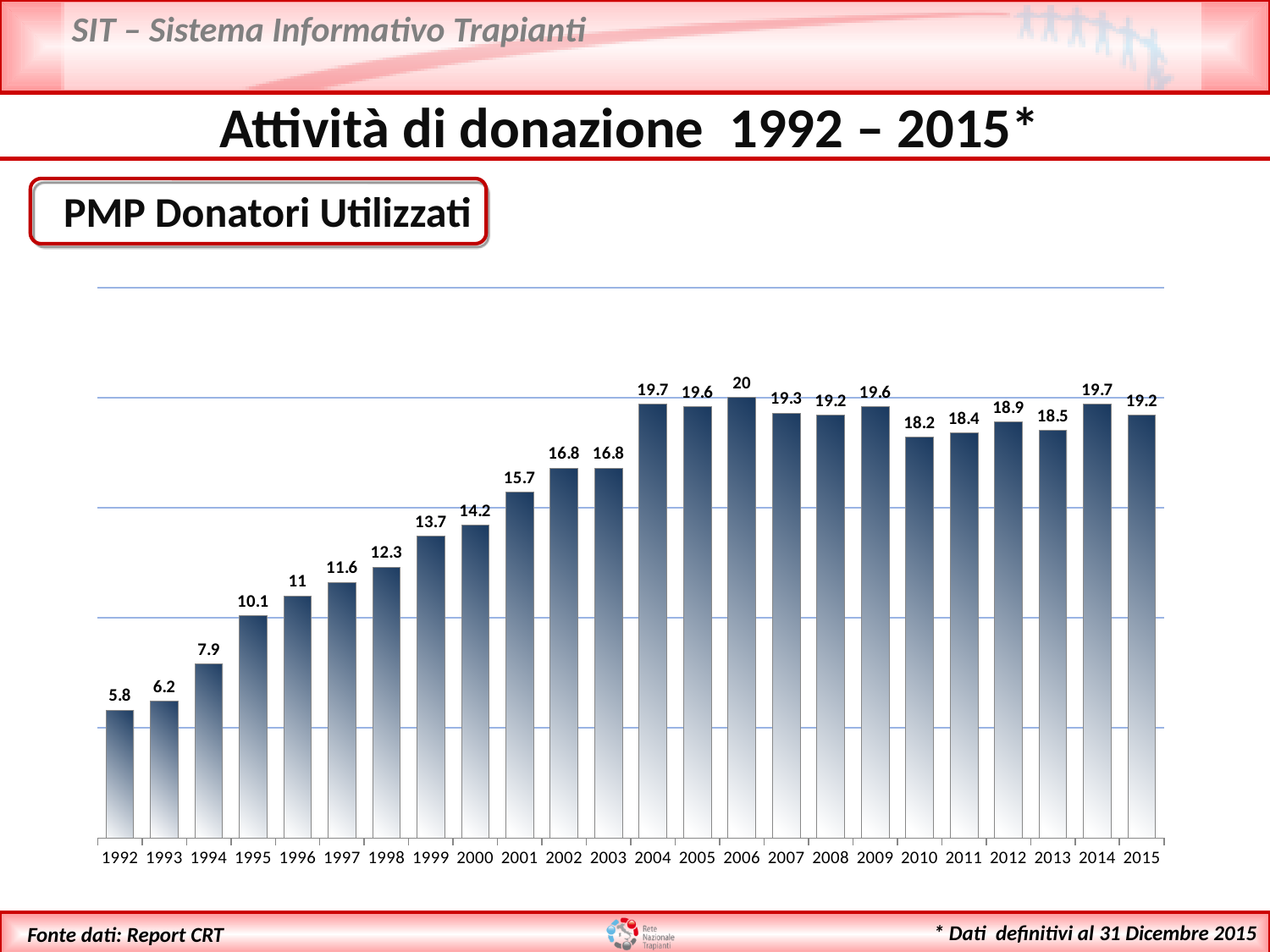
How many years (bars) are shown in the chart? 24 What is the difference between the values for 2006 and 1992? 14.2 What is the value shown for 2015? 19.2 What kind of chart is shown on the slide? Bar chart Do the values rise or fall from 1992 to 2004? Rise Which year has the highest value in the chart? 2006 What is the title shown in the box above the chart? PMP Donatori Utilizzati Which year has the lowest value in the chart? 1992 What is the value shown for 1992? 5.8 What is the PMP Donatori Utilizzati value for 2006? 20 What is the difference between the values for 2014 and 2015? 0.5 Which year has a larger value, 2010 or 2012? 2012